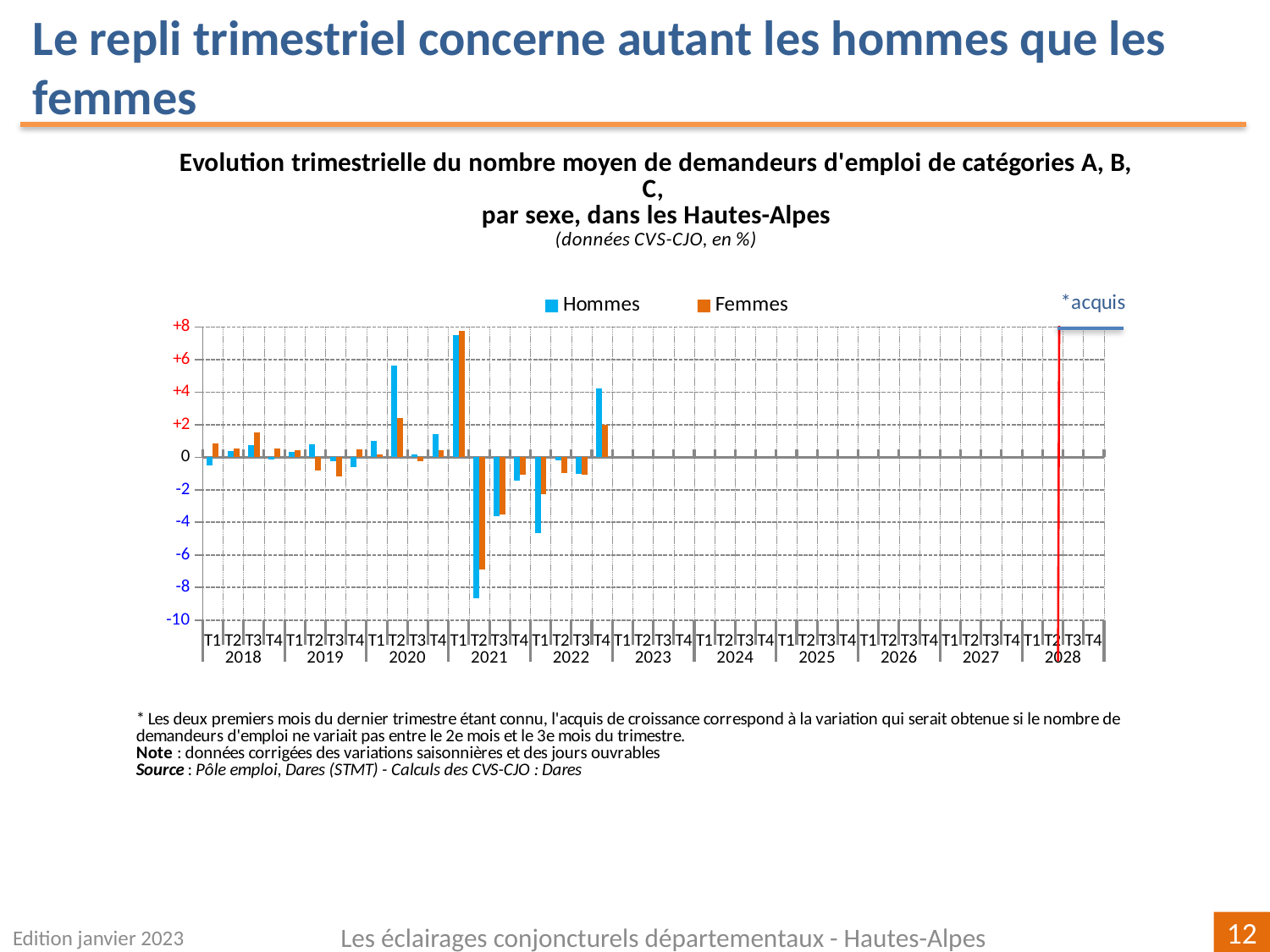
What kind of chart is shown on the slide? bar chart Is the value for Hommes in T2 2021 greater or less than -8? less Which two series are listed in the legend? Hommes and Femmes Is the value for Femmes in T1 2021 greater or less than +6? greater Is the value for Femmes in T2 2021 greater or less than -6? less In T2 2020, which series has the larger value, Hommes or Femmes? Hommes In which quarter is the Hommes series at its lowest value? T2 2021 In which quarter is the Femmes series at its highest value? T1 2021 Which colour represents the Femmes series? orange How many series does the legend list? 2